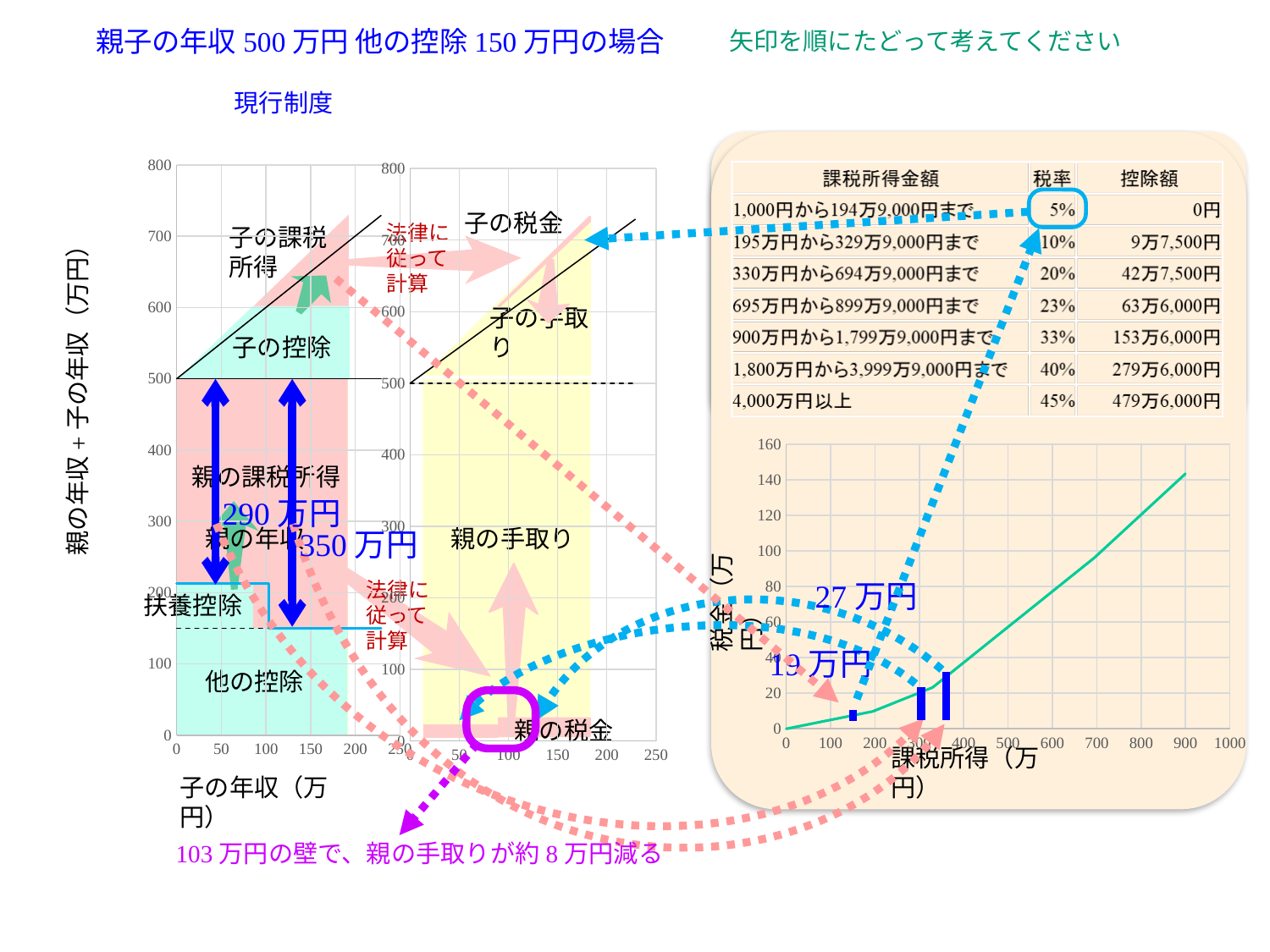
In the lower-right chart (税金 vs 課税所得), is the value at 課税所得 100 greater or less than 20? less In the left chart (現行制度), what value is annotated for 親の年収 with the blue arrow? 350 万円 In the left chart (現行制度), what value is annotated for 親の課税所得 with the blue arrow? 290 万円 In the lower-right chart (税金 vs 課税所得), what two tax amounts are annotated in blue next to the marked points? 27 万円 and 19 万円 What kind of chart is the chart in the lower right with the x axis 課税所得（万円）? line chart What is the x-axis label of the left chart titled 現行制度? 子の年収（万円） In the lower-right chart (税金 vs 課税所得), is the value at 課税所得 900 greater or less than 120? greater In the lower-right chart (税金 vs 課税所得), what is the highest value shown on the y axis? 160 In the lower-right chart (税金 vs 課税所得), what is the highest value shown on the x axis? 1000 In the tax-rate table at the top right, what is the 税率 for 330万円から694万9,000円まで? 20% In the lower-right chart (税金 vs 課税所得), is the value at 課税所得 300 greater or less than 40? less In the lower-right chart (税金 vs 課税所得), do the values rise or fall as 課税所得 increases? rise